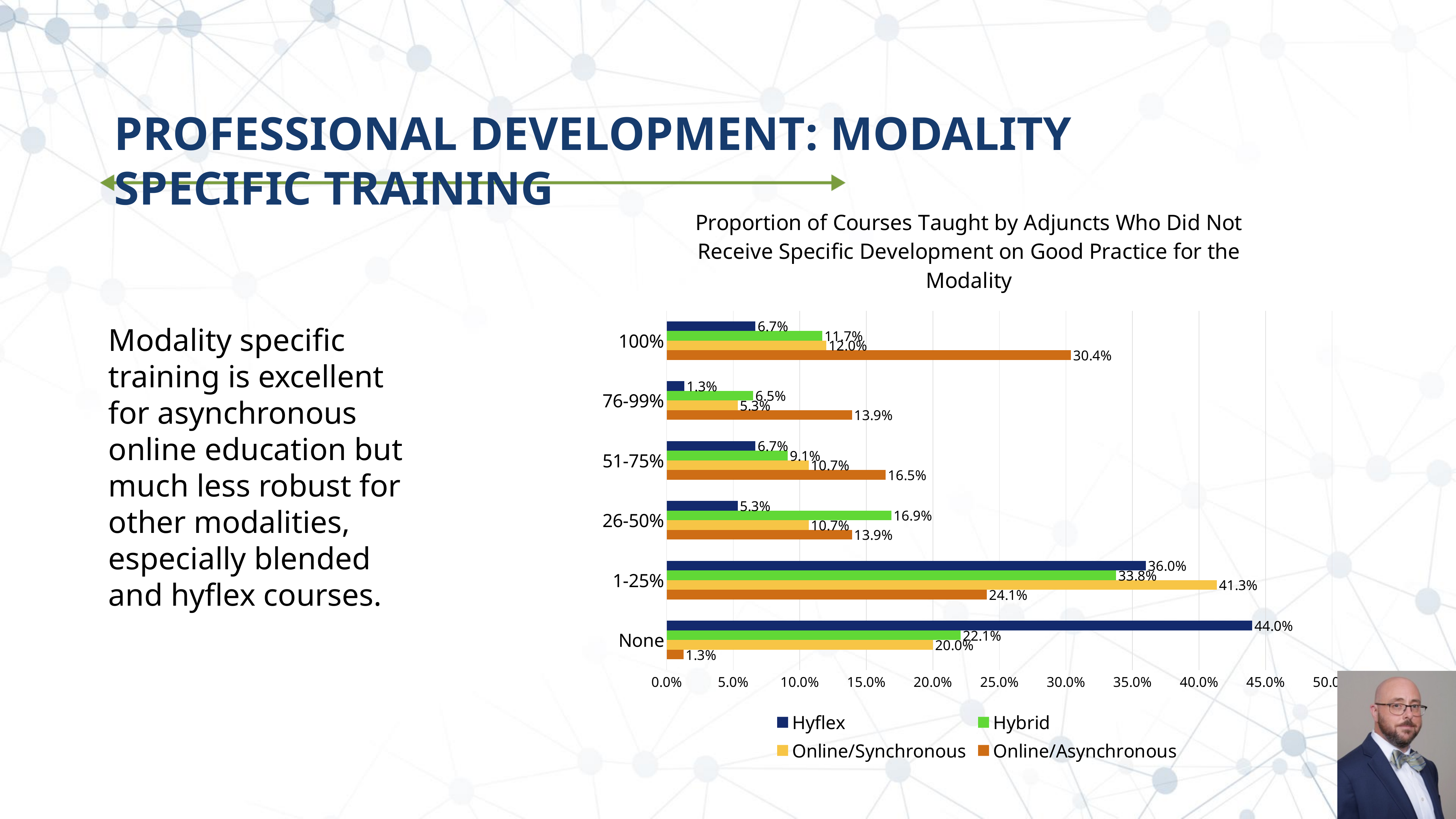
What kind of chart is shown on the slide? Bar chart What is the Online/Asynchronous value for the 100% category? 30.4% How many series does the legend list? 4 Which is larger for the 1-25% category, the Hyflex value or the Hybrid value? Hyflex How many categories are shown on the y axis? 6 Which series is shown in orange in the legend? Online/Asynchronous What is the Online/Synchronous value for the 1-25% category? 41.3% What is the Hyflex value for the None category? 44.0% Which category has the highest Hyflex value? None What is the Hybrid value for the 26-50% category? 16.9% What is the difference between the Hyflex and Online/Asynchronous values for the None category? 42.7% Which category has the lowest Online/Asynchronous value? None